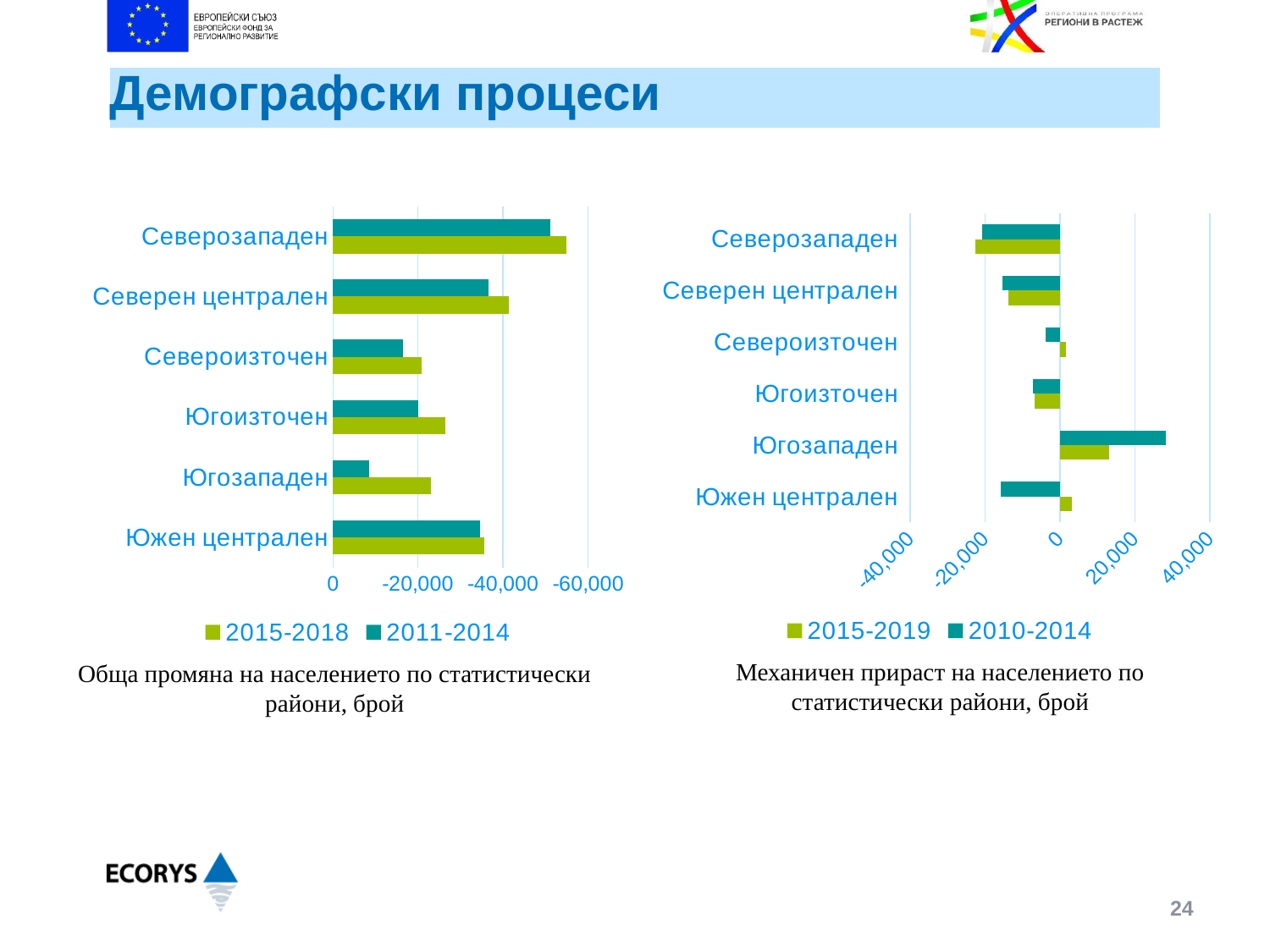
How many statistical regions are shown in the left chart, 'Обща промяна на населението по статистически райони, брой'? 6 In the left chart, 'Обща промяна на населението', which region shows the smallest population decline in 2011-2014? Югозападен In the right chart, 'Механичен прираст на населението', which region has the highest value in 2010-2014? Югозападен In the left chart, 'Обща промяна на населението', is the 2011-2014 value for Югозападен greater or less than -20,000? greater In the left chart, 'Обща промяна на населението', is the 2015-2018 value for Северозападен greater or less than -40,000? less In the right chart, 'Механичен прираст на населението', which series has the larger value for Югозападен, 2015-2019 or 2010-2014? 2010-2014 What type of chart is the left chart, 'Обща промяна на населението по статистически райони, брой'? Bar chart What are the two series listed in the legend of the left chart, 'Обща промяна на населението по статистически райони, брой'? 2015-2018 and 2011-2014 In the right chart, 'Механичен прираст на населението', is the 2010-2014 value for Югозападен greater or less than 20,000? greater In the left chart, 'Обща промяна на населението', which region shows the largest population decline in 2015-2018? Северозападен How many series does the legend of the right chart, 'Механичен прираст на населението по статистически райони, брой', list? 2